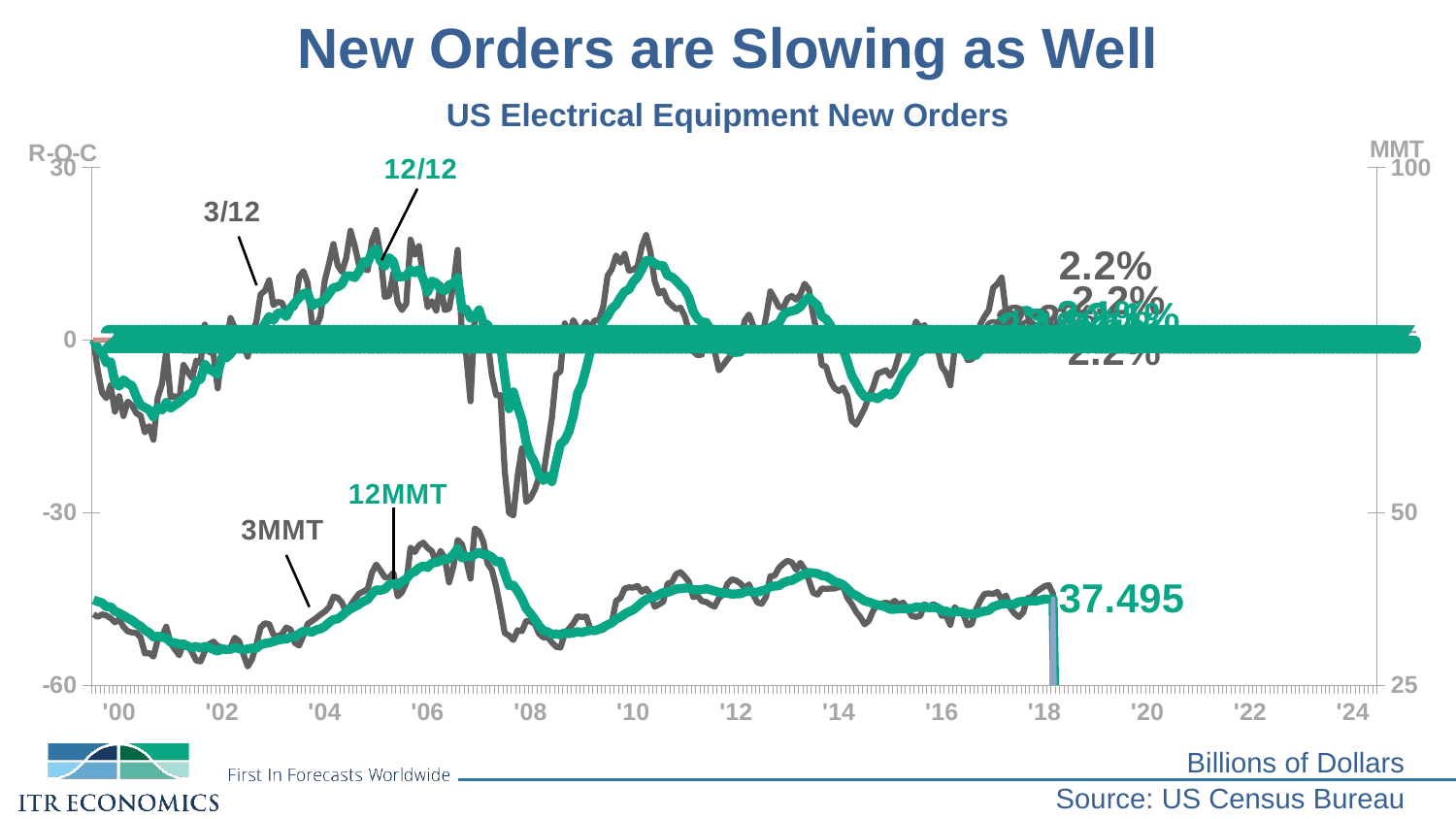
Is the 12/12 rate-of-change value around 2005 greater or less than 0? greater Is the 12/12 rate-of-change value around 2009 greater or less than 0? less What is the source of the data shown on the chart? US Census Bureau What kind of chart is shown on the slide? Line chart What is the last year label shown on the x axis? '24 What is the first year label shown on the x axis? '00 What is the latest 12MMT value labeled on the chart? 37.495 How many data series are labeled on the chart? 4 What is the title of the chart? US Electrical Equipment New Orders In what units are the MMT values expressed, according to the note at the bottom right? Billions of Dollars Is the 12MMT value at the end of the series (37.495) greater or less than 50 on the right-hand MMT axis? less